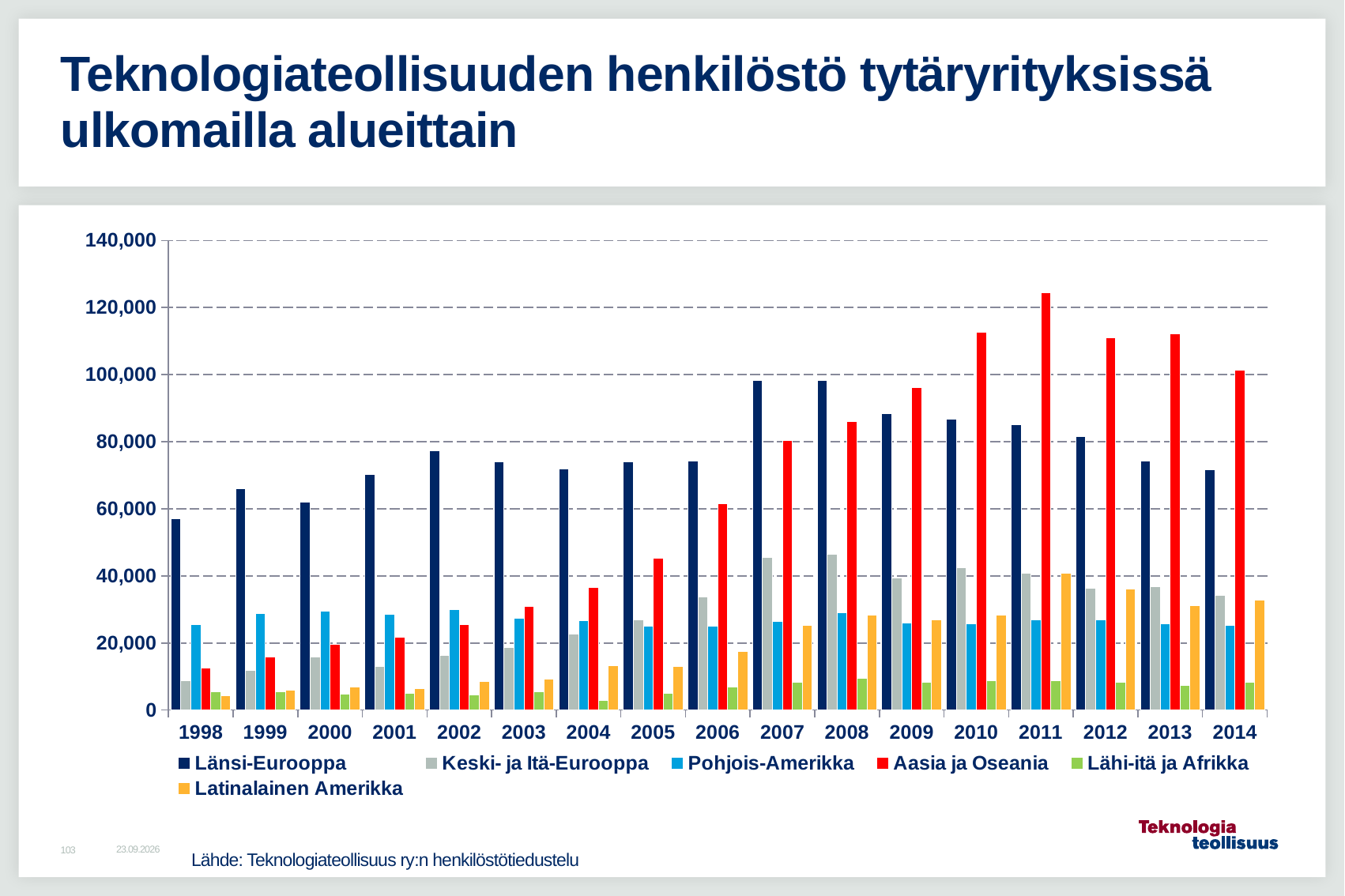
In which year is the value for Aasia ja Oseania highest? 2011 Is the value for Keski- ja Itä-Eurooppa in 2008 greater or less than 40,000? greater Is the value for Aasia ja Oseania in 2011 greater or less than 120,000? greater What kind of chart is shown on the slide? bar chart Is the value for Länsi-Eurooppa in 1998 greater or less than 60,000? less In 2014, which is larger: Aasia ja Oseania or Länsi-Eurooppa? Aasia ja Oseania Does the value for Aasia ja Oseania rise or fall from 1998 to 2011? rise What colour represents Aasia ja Oseania in the legend? red How many series does the legend list? 6 How many years are shown on the x axis? 17 In which year is the value for Länsi-Eurooppa lowest? 1998